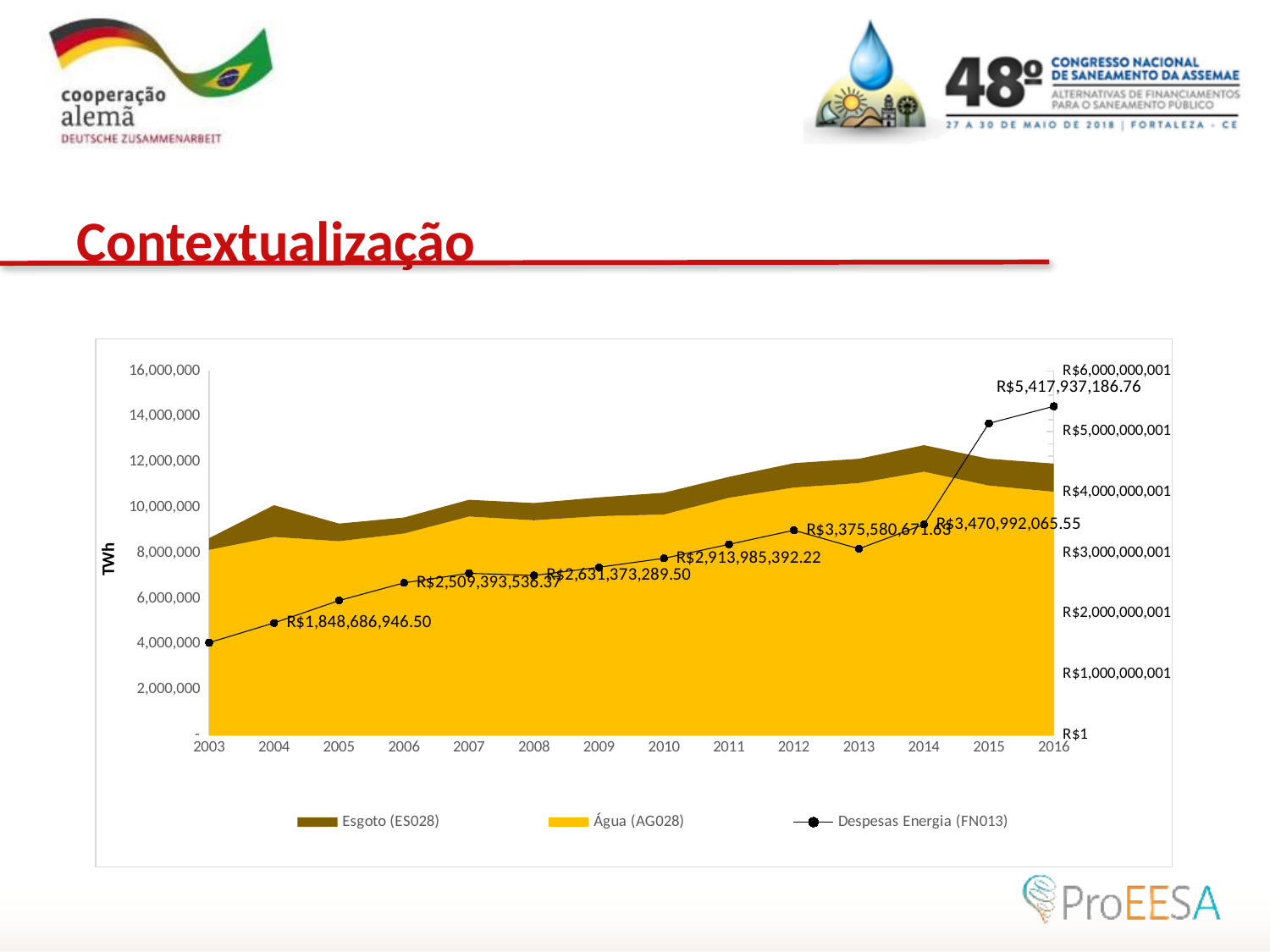
What is the difference between the Despesas Energia (FN013) values for 2016 and 2014? R$1,946,945,121.21 What is the value of Despesas Energia (FN013) in 2016? R$5,417,937,186.76 What is the value of Despesas Energia (FN013) in 2012? R$3,375,580,671.63 Which year has the highest Despesas Energia (FN013) value? 2016 Which year has the lowest Despesas Energia (FN013) value? 2003 What is the difference between the Despesas Energia (FN013) values for 2006 and 2004? R$660,706,589.87 What kind of chart is used to plot the Despesas Energia (FN013) series? line chart How many years are shown on the x axis? 14 How many series does the legend list? 3 What is the value of Despesas Energia (FN013) in 2004? R$1,848,686,946.50 Is the value for Água (AG028) in 2003 greater or less than 10,000,000? less Does the Despesas Energia (FN013) series generally rise or fall from 2003 to 2016? rise